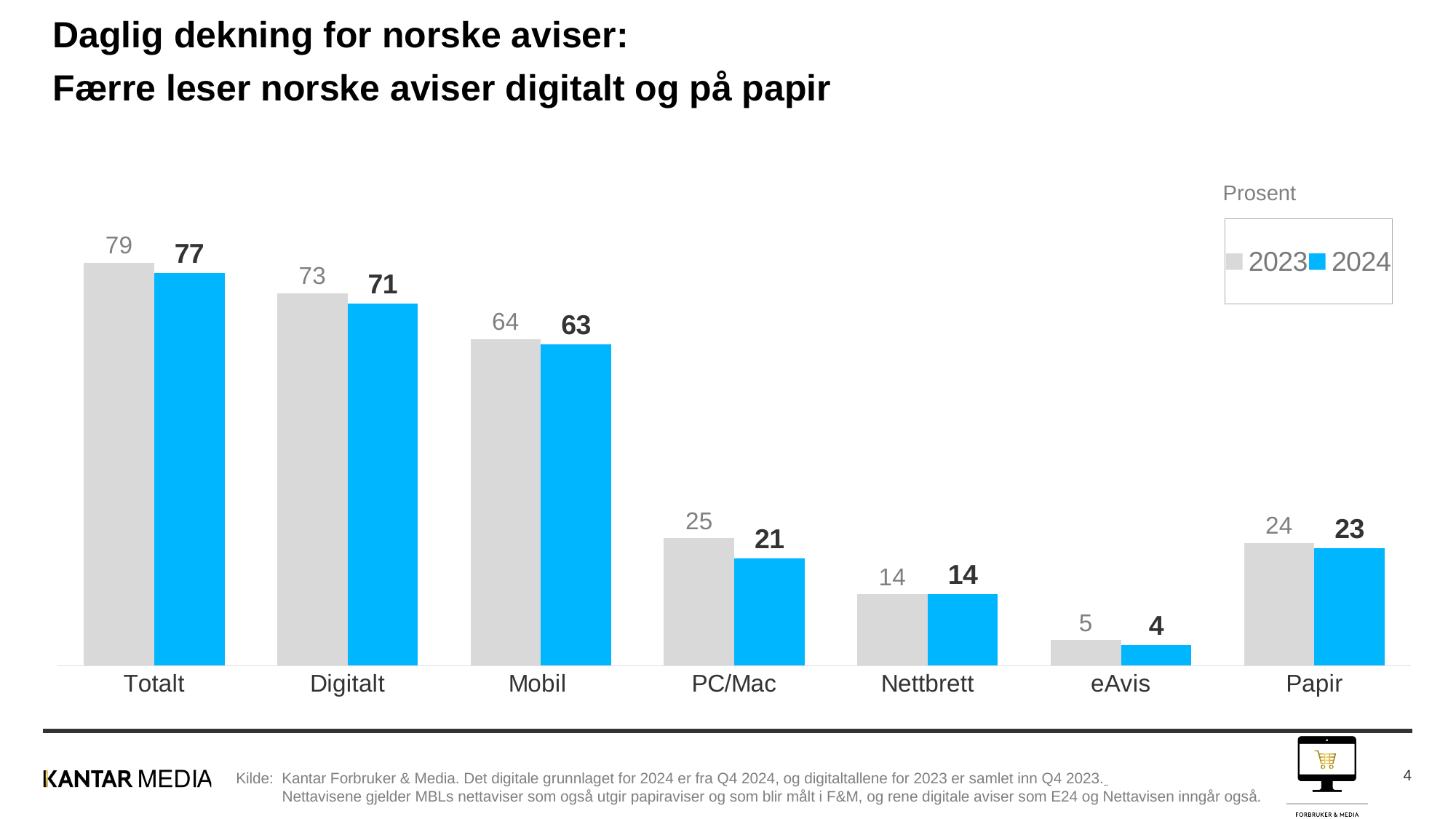
What unit is indicated above the legend? Prosent Which is larger, the 2023 value for Papir or the 2023 value for Nettbrett? Papir How many series does the legend list? 2 How many categories are shown on the x axis? 7 What is the 2023 value for PC/Mac? 25 What kind of chart is shown on the slide? Bar chart Which category has the lowest 2023 value? eAvis What is the difference between the 2024 values for Digitalt and Papir? 48 What is the difference between the 2023 and 2024 values for PC/Mac? 4 What is the 2024 value for Mobil? 63 Which category has the highest 2024 value? Totalt What is the 2024 value for eAvis? 4